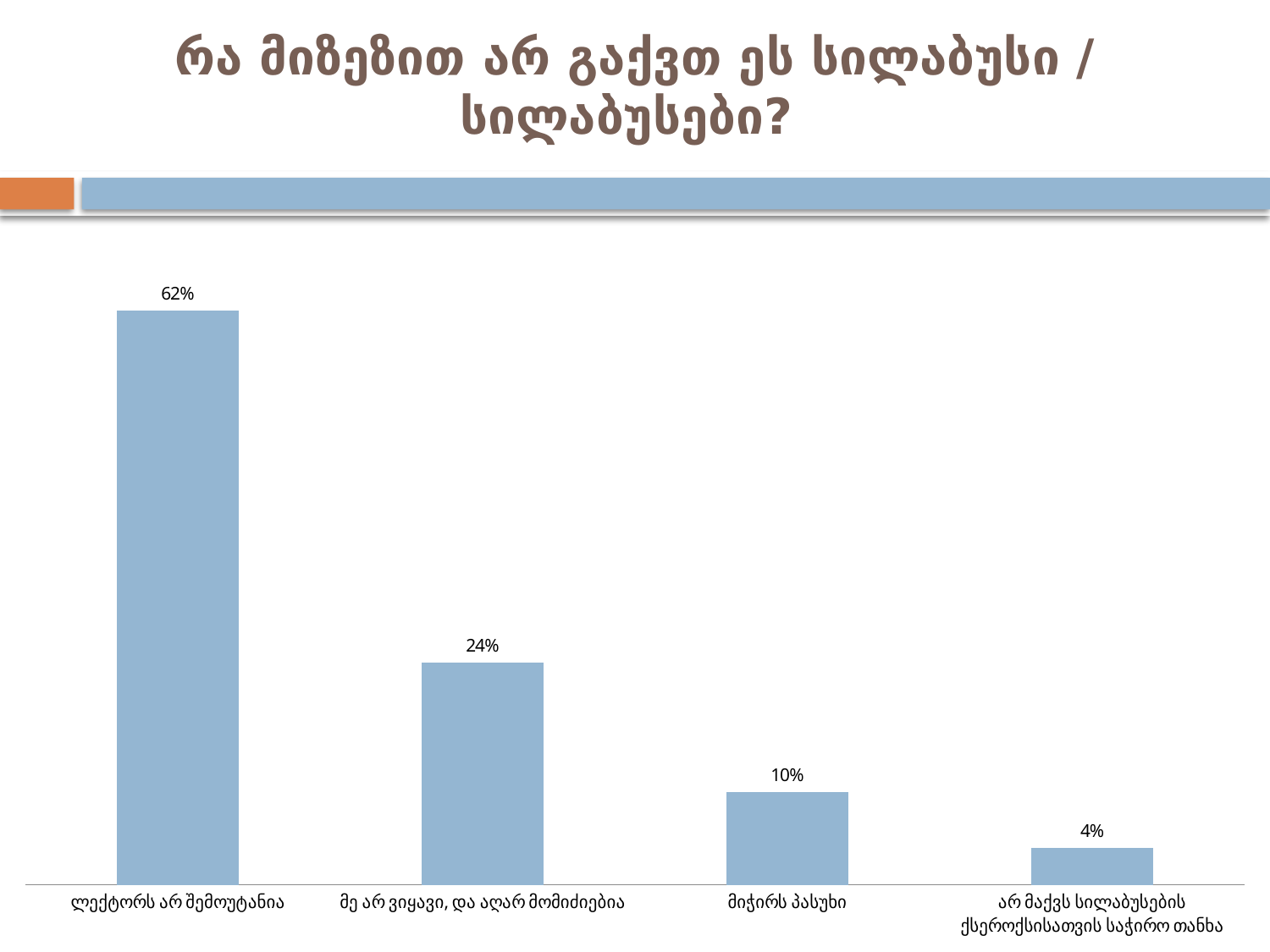
What value is shown for the category "მიჭირს პასუხი"? 10% Which is larger: the value for "მე არ ვიყავი, და აღარ მომიძებია" or the value for "მიჭირს პასუხი"? მე არ ვიყავი, და აღარ მომიძებია How many categories are shown in the chart? 4 What is the difference between the values for "ლექტორს არ შემოუტანია" and "მე არ ვიყავი, და აღარ მომიძებია"? 38% What value is shown for the category "არ მაქვს სილაბუსების ქსეროქსისათვის საჭირო თანხა"? 4% What value is shown for the category "მე არ ვიყავი, და აღარ მომიძებია"? 24% What value is shown for the category "ლექტორს არ შემოუტანია"? 62% Which category has the lowest value? არ მაქვს სილაბუსების ქსეროქსისათვის საჭირო თანხა Do the values rise or fall from left to right across the categories? Fall Which category has the highest value? ლექტორს არ შემოუტანია What is the difference between the values for "მიჭირს პასუხი" and "არ მაქვს სილაბუსების ქსეროქსისათვის საჭირო თანხა"? 6% What kind of chart is shown on the slide? Bar chart